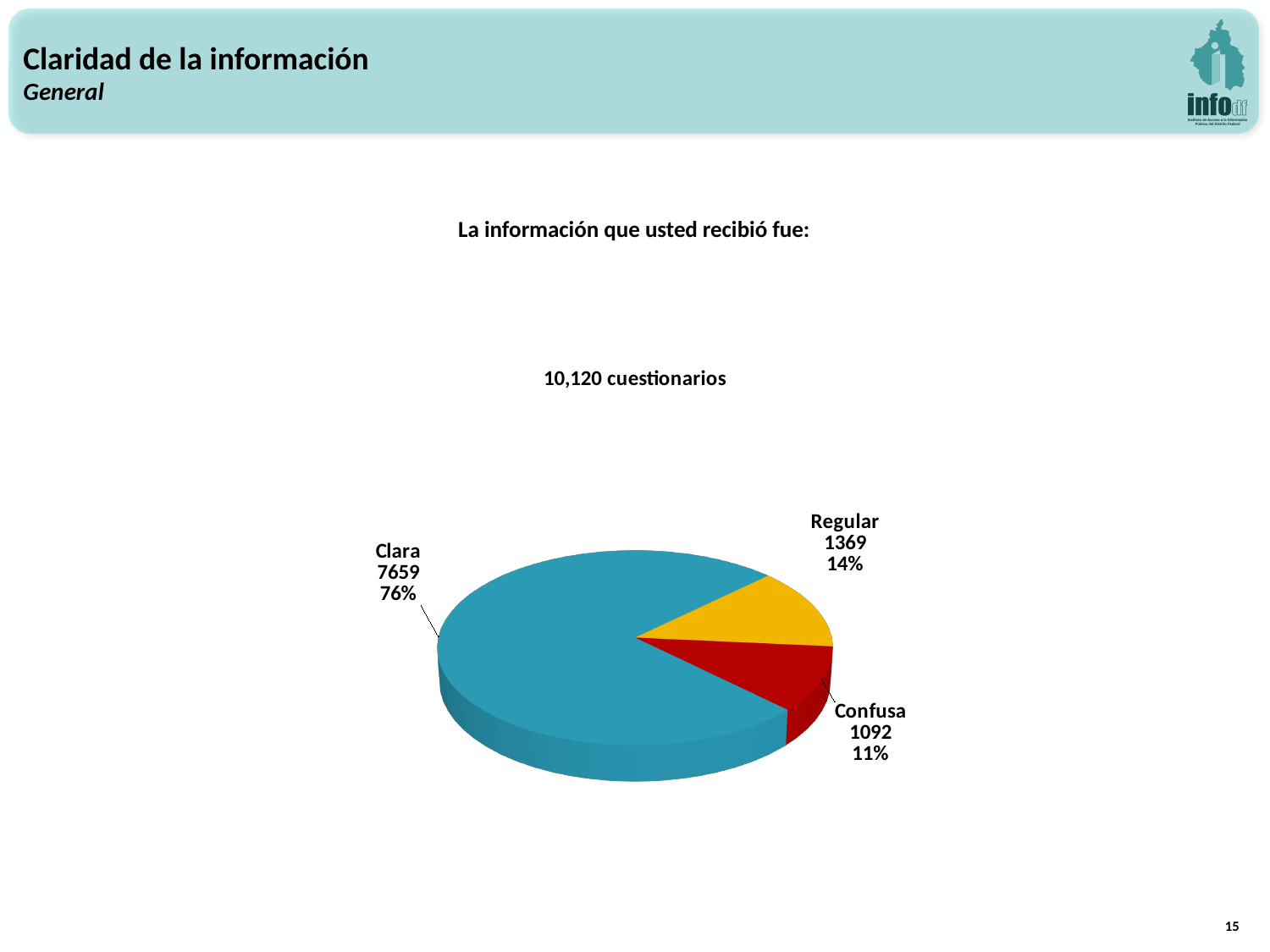
Which is larger, the value for Regular or the value for Confusa? Regular What is the value for Regular? 1369 How many slices does the pie chart have? 3 What is the difference between the values for Regular and Confusa? 277 Which category has the smallest slice? Confusa What share of the pie does Confusa represent? 11% What share of the pie does Clara represent? 76% What is the value for Confusa? 1092 What colour is the Regular slice? yellow What is the value for Clara? 7659 Which category has the largest slice? Clara What kind of chart is shown on the slide? pie chart